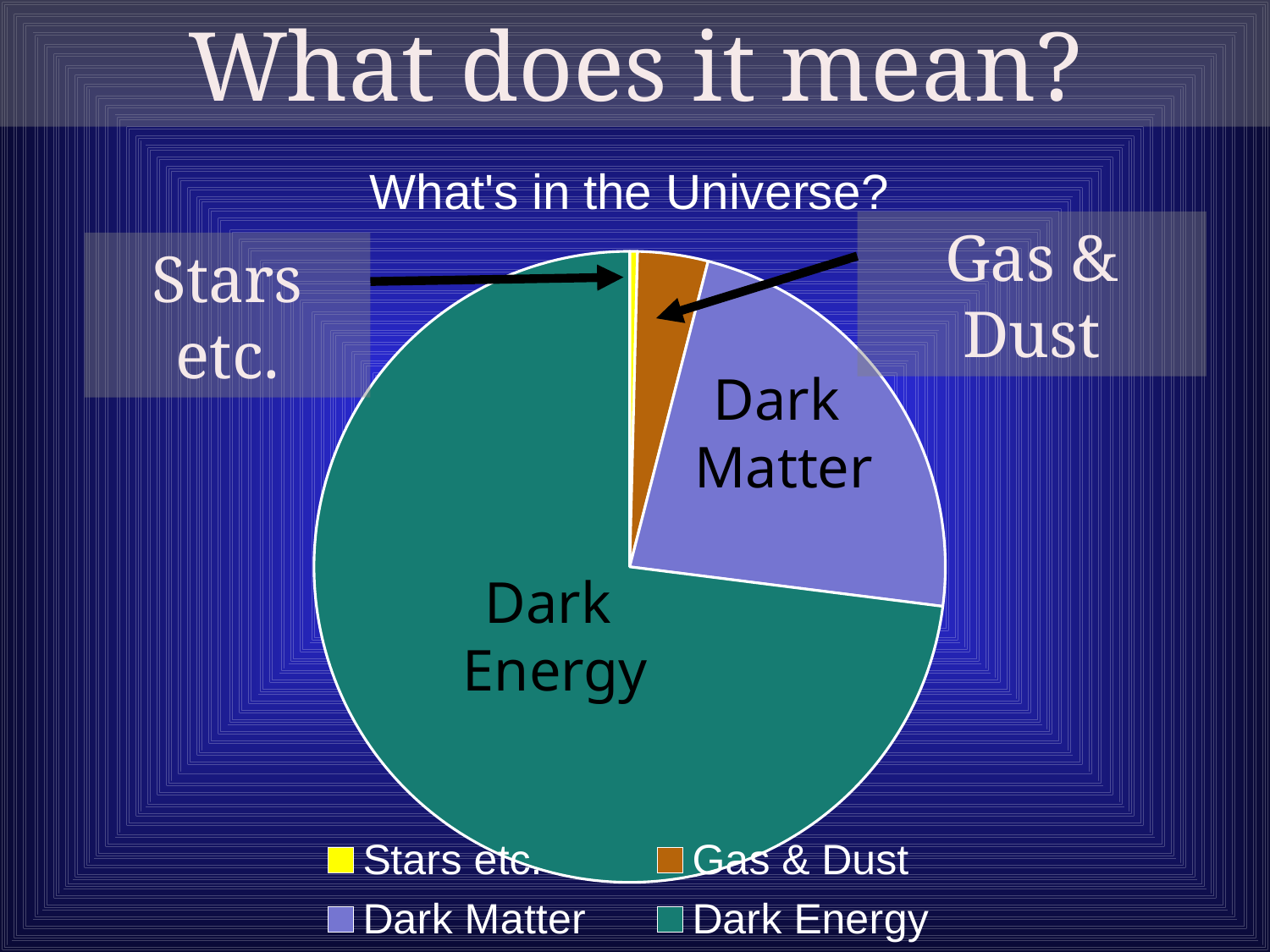
Which slice of the pie chart is the smallest? Stars etc. Which slice of the pie chart is the largest? Dark Energy How many slices does the pie chart have? 4 Which slice is the second largest in the pie chart? Dark Matter What is the title of the pie chart? What's in the Universe? Which is larger, the Dark Energy slice or the Dark Matter slice? Dark Energy Which is larger, the Dark Matter slice or the Gas & Dust slice? Dark Matter What colour is the Dark Energy slice in the pie chart? teal (green) What kind of chart is shown on the slide? pie chart Which is larger, the Gas & Dust slice or the Stars etc. slice? Gas & Dust How many entries does the legend list? 4